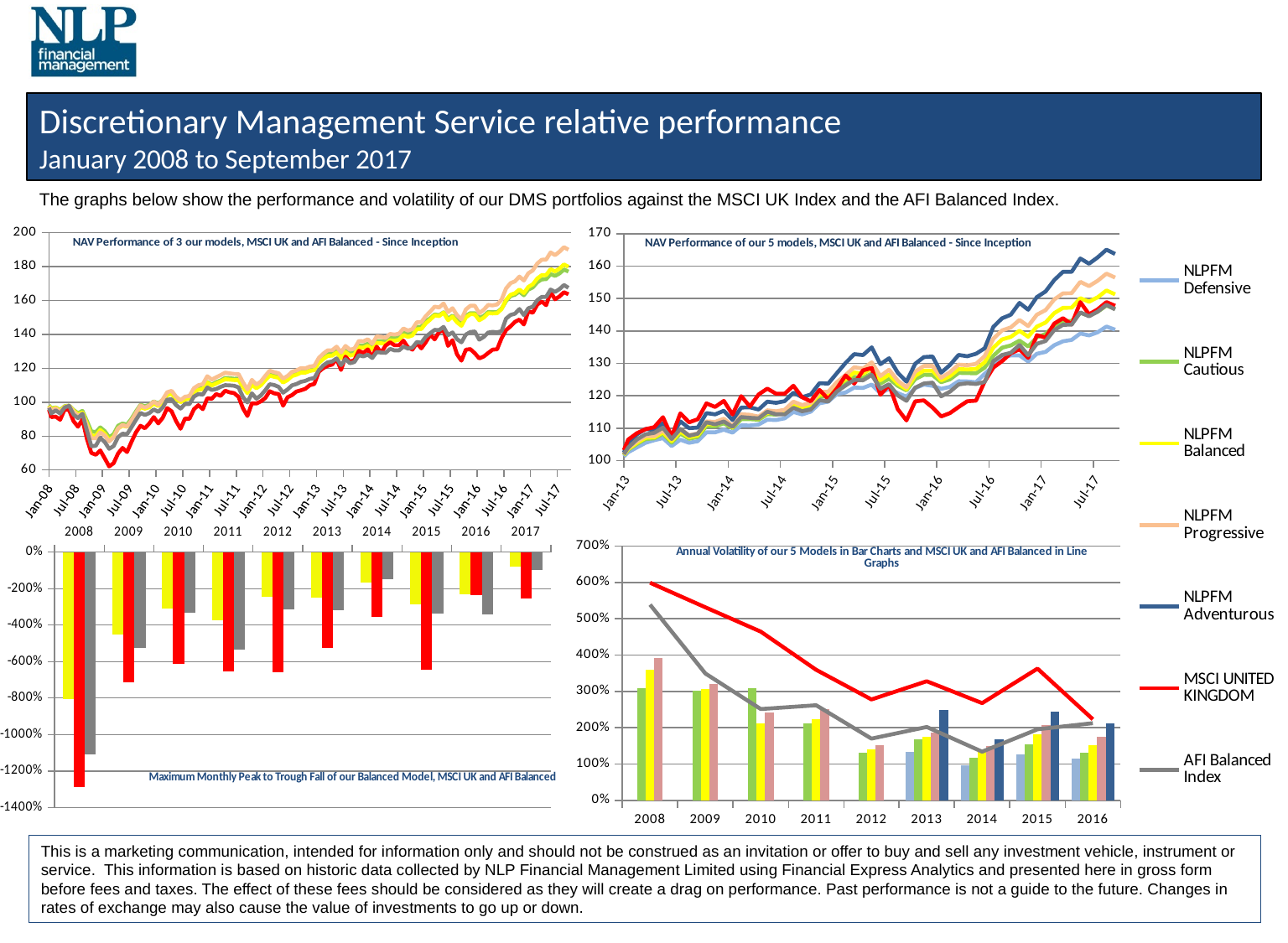
In the top-right chart 'NAV Performance of our 5 models', is the NLPFM Adventurous value at Jul-17 greater or less than 160? greater In the bottom-right chart 'Annual Volatility of our 5 Models', how many years are shown on the x axis? 9 In the bottom-right chart 'Annual Volatility of our 5 Models', does the MSCI UNITED KINGDOM line overall rise or fall from 2008 to 2016? fall In the top-left chart 'NAV Performance of 3 our models', is the MSCI UNITED KINGDOM value at Jan-09 greater or less than 80? less In the top-right chart 'NAV Performance of our 5 models', which series is highest at the end of the period (Jul-17)? NLPFM Adventurous In the bottom-left chart 'Maximum Monthly Peak to Trough Fall', which year shows the largest fall for MSCI UK? 2008 In the bottom-right chart 'Annual Volatility of our 5 Models', is the MSCI UNITED KINGDOM value for 2008 greater or less than 500%? greater How many series does the shared legend on the right of the slide list? 7 In the bottom-left chart 'Maximum Monthly Peak to Trough Fall', how many years are shown on the x axis? 10 What kind of chart is the top-left chart titled 'NAV Performance of 3 our models, MSCI UK and AFI Balanced - Since Inception'? line chart What kind of chart is the bottom-left chart titled 'Maximum Monthly Peak to Trough Fall of our Balanced Model, MSCI UK and AFI Balanced'? bar chart